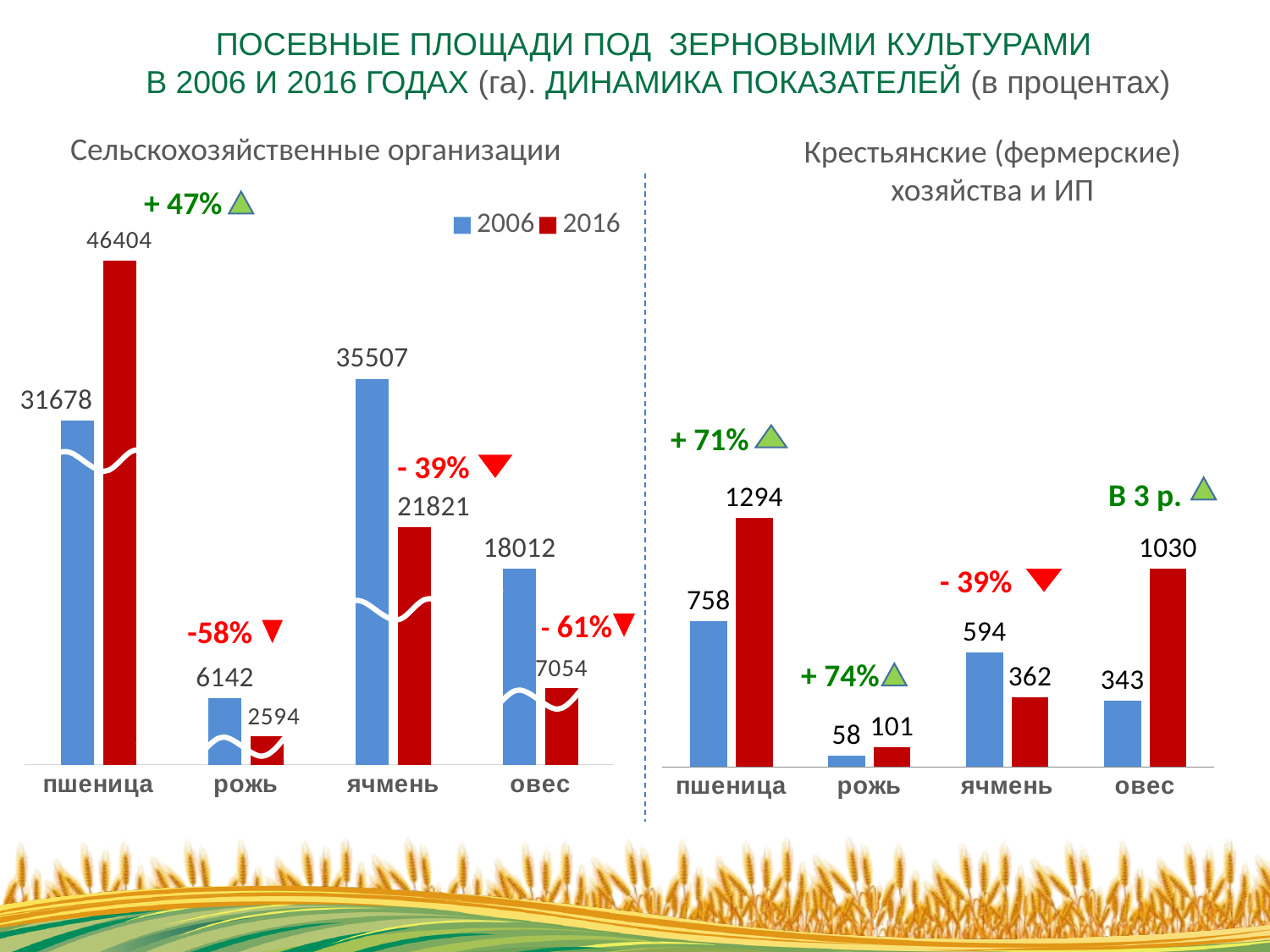
In the chart titled 'Сельскохозяйственные организации', what is the value for пшеница in 2016? 46404 How many categories are shown on the x axis of the chart titled 'Сельскохозяйственные организации'? 4 In the chart titled 'Сельскохозяйственные организации', which is larger for рожь: the 2006 value or the 2016 value? 2006 In the chart titled 'Крестьянские (фермерские) хозяйства и ИП', what is the difference between the 2016 and 2006 values for пшеница? 536 In the chart titled 'Сельскохозяйственные организации', which category has the lowest 2016 value? рожь In the chart titled 'Сельскохозяйственные организации', what is the value for ячмень in 2006? 35507 In the chart titled 'Крестьянские (фермерские) хозяйства и ИП', which is larger for ячмень: the 2006 value or the 2016 value? 2006 In the chart titled 'Крестьянские (фермерские) хозяйства и ИП', what is the value for овес in 2016? 1030 In the chart titled 'Крестьянские (фермерские) хозяйства и ИП', what is the value for рожь in 2006? 58 How many series does the legend list for the chart titled 'Сельскохозяйственные организации'? 2 In the chart titled 'Крестьянские (фермерские) хозяйства и ИП', which category has the highest 2016 value? пшеница In the chart titled 'Сельскохозяйственные организации', what is the difference between the 2006 and 2016 values for овес? 10958